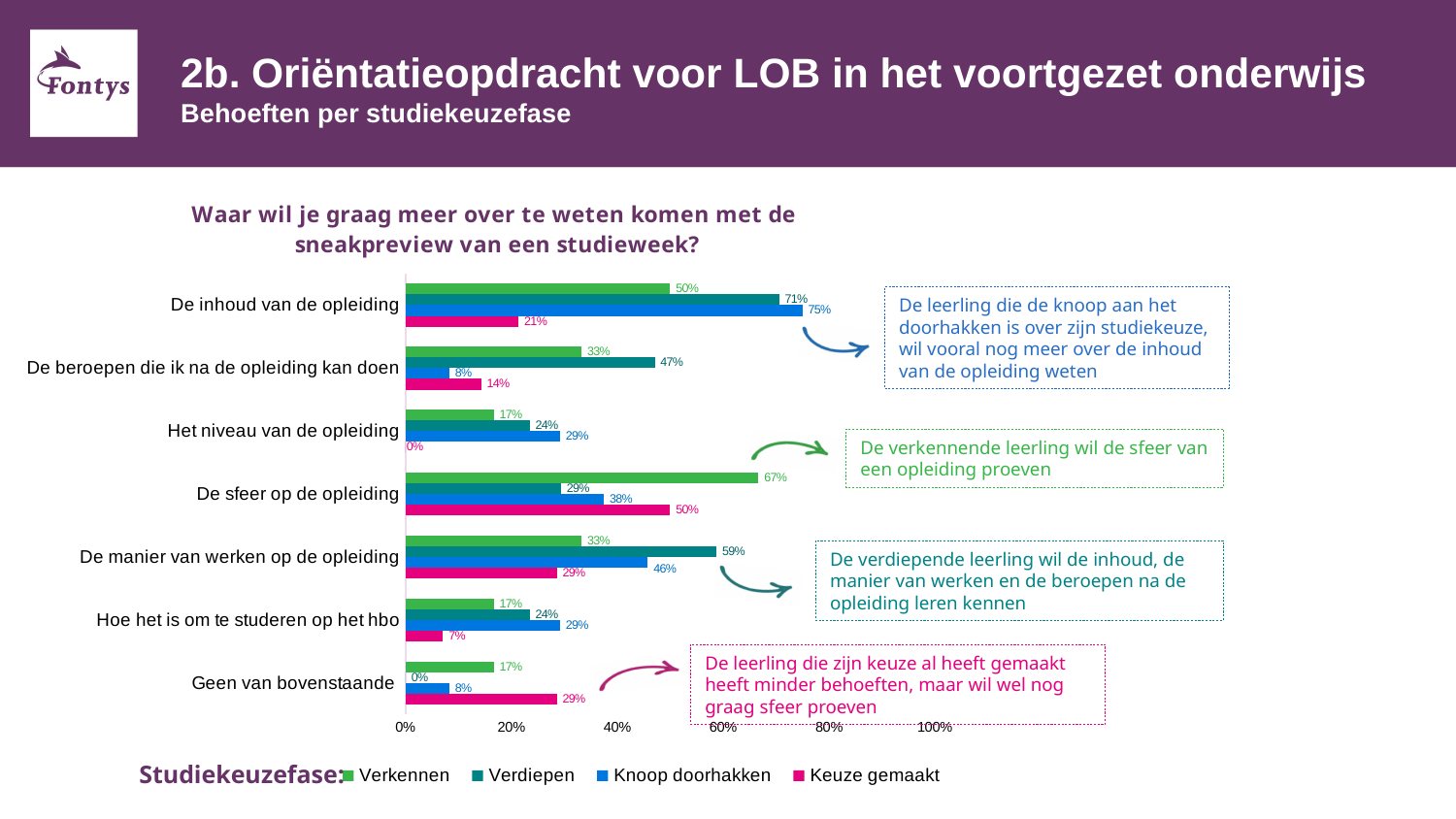
How many categories are shown on the chart? 7 For 'De beroepen die ik na de opleiding kan doen', which is larger: the Verdiepen value or the Keuze gemaakt value? Verdiepen What is the difference between the Verdiepen and Verkennen values for 'De manier van werken op de opleiding'? 26% How many series does the legend list? 4 What is the value for Knoop doorhakken for 'De inhoud van de opleiding'? 75% What is the value for Keuze gemaakt for 'Geen van bovenstaande'? 29% What is the title of the chart? Waar wil je graag meer over te weten komen met de sneakpreview van een studieweek? What is the value for Verkennen for 'De sfeer op de opleiding'? 67% Which category has the lowest value for the Keuze gemaakt series? Het niveau van de opleiding What kind of chart is shown on the slide? bar chart Which category has the highest value for the Verdiepen series? De inhoud van de opleiding Is the Knoop doorhakken value for 'De inhoud van de opleiding' greater or less than 60%? greater